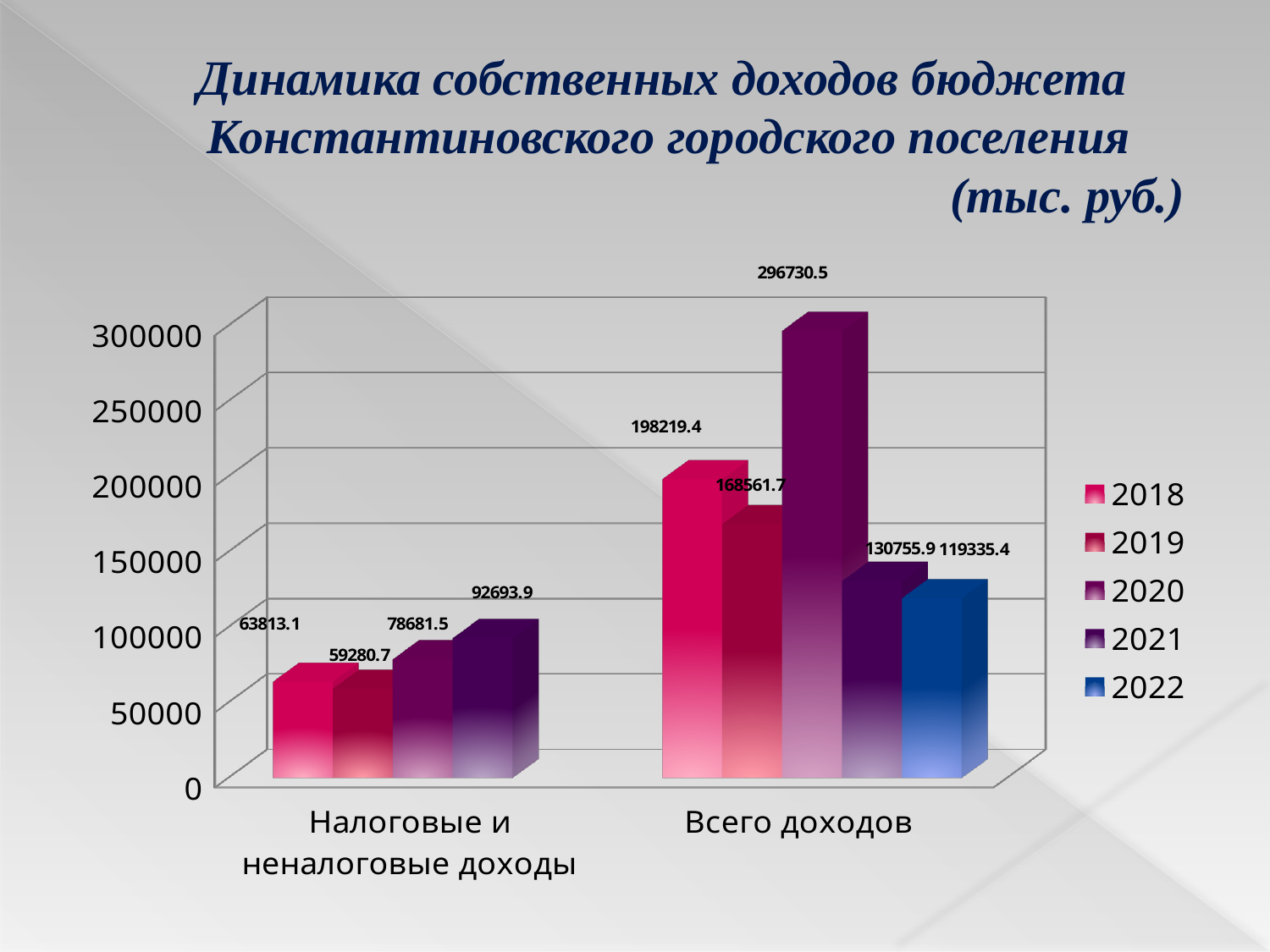
Which year has the highest value in the "Всего доходов" category? 2020 What is the difference between the 2020 and 2018 values in the "Всего доходов" category? 98511.1 In the "Всего доходов" category, which is larger: the value for 2018 or for 2019? 2018 What is the value for 2021 in the "Налоговые и неналоговые доходы" category? 92693.9 How many series does the legend list? 5 Which year has the lowest value in the "Налоговые и неналоговые доходы" category? 2019 What is the value for 2020 in the "Всего доходов" category? 296730.5 Which year has the lowest value in the "Всего доходов" category? 2022 What is the difference between the 2018 and 2019 values in the "Налоговые и неналоговые доходы" category? 4532.4 What kind of chart is shown on the slide? Bar chart What is the value for 2022 in the "Всего доходов" category? 119335.4 How many categories are shown on the x axis? 2